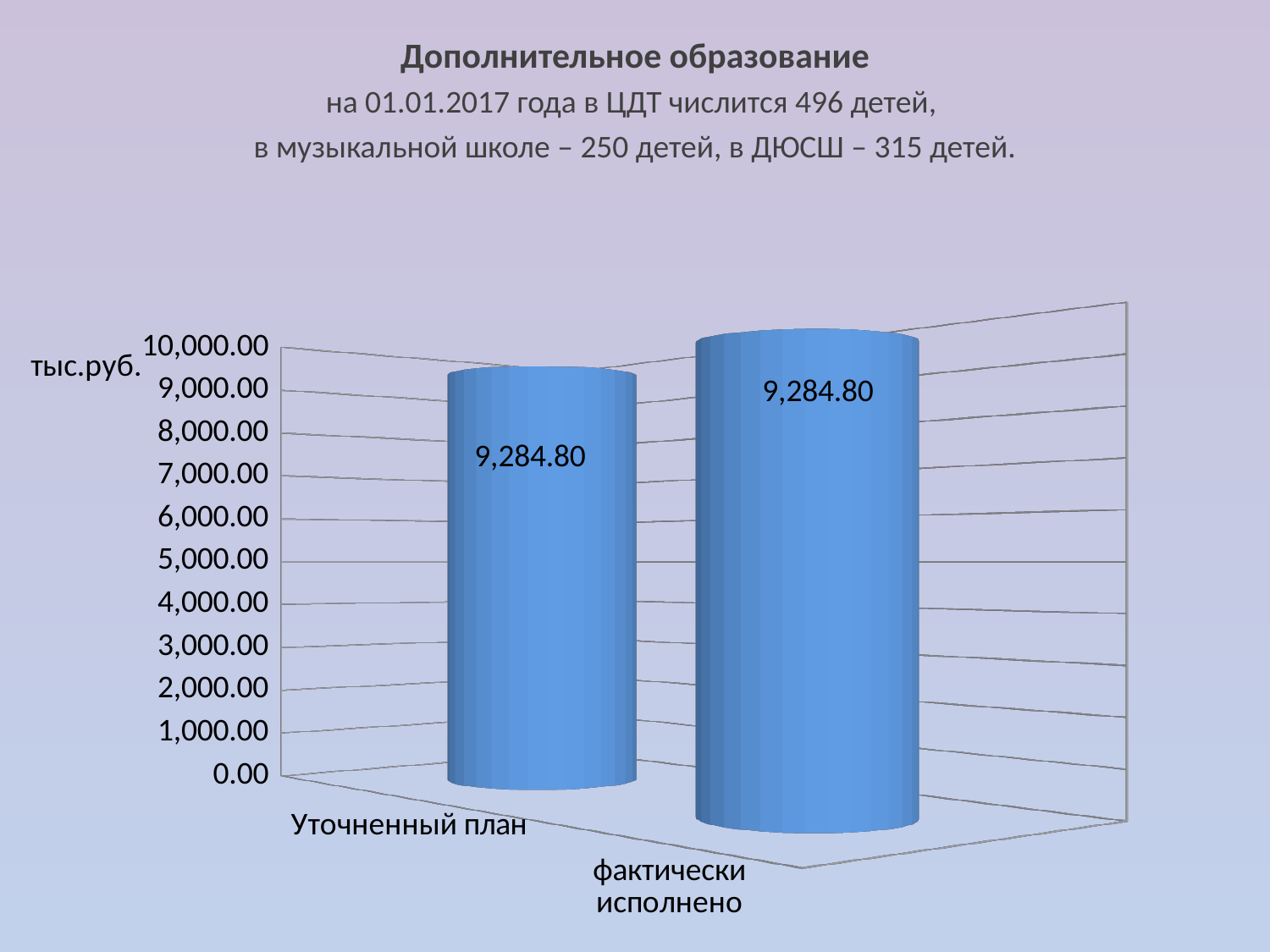
Is the value for Уточненный план greater or less than 10,000.00? less What is the highest tick value shown on the vertical axis? 10,000.00 What is the difference between the values for Уточненный план and фактически исполнено? 0.00 What is the value for фактически исполнено? 9,284.80 What kind of chart is shown on the slide? bar chart What is the title of the slide containing the chart? Дополнительное образование What is the value for Уточненный план? 9,284.80 Is the value for фактически исполнено greater or less than 9,000.00? greater What unit is shown on the vertical axis of the chart? тыс.руб. How many categories are shown on the x axis of the chart? 2 Are the values for Уточненный план and фактически исполнено equal or different? equal